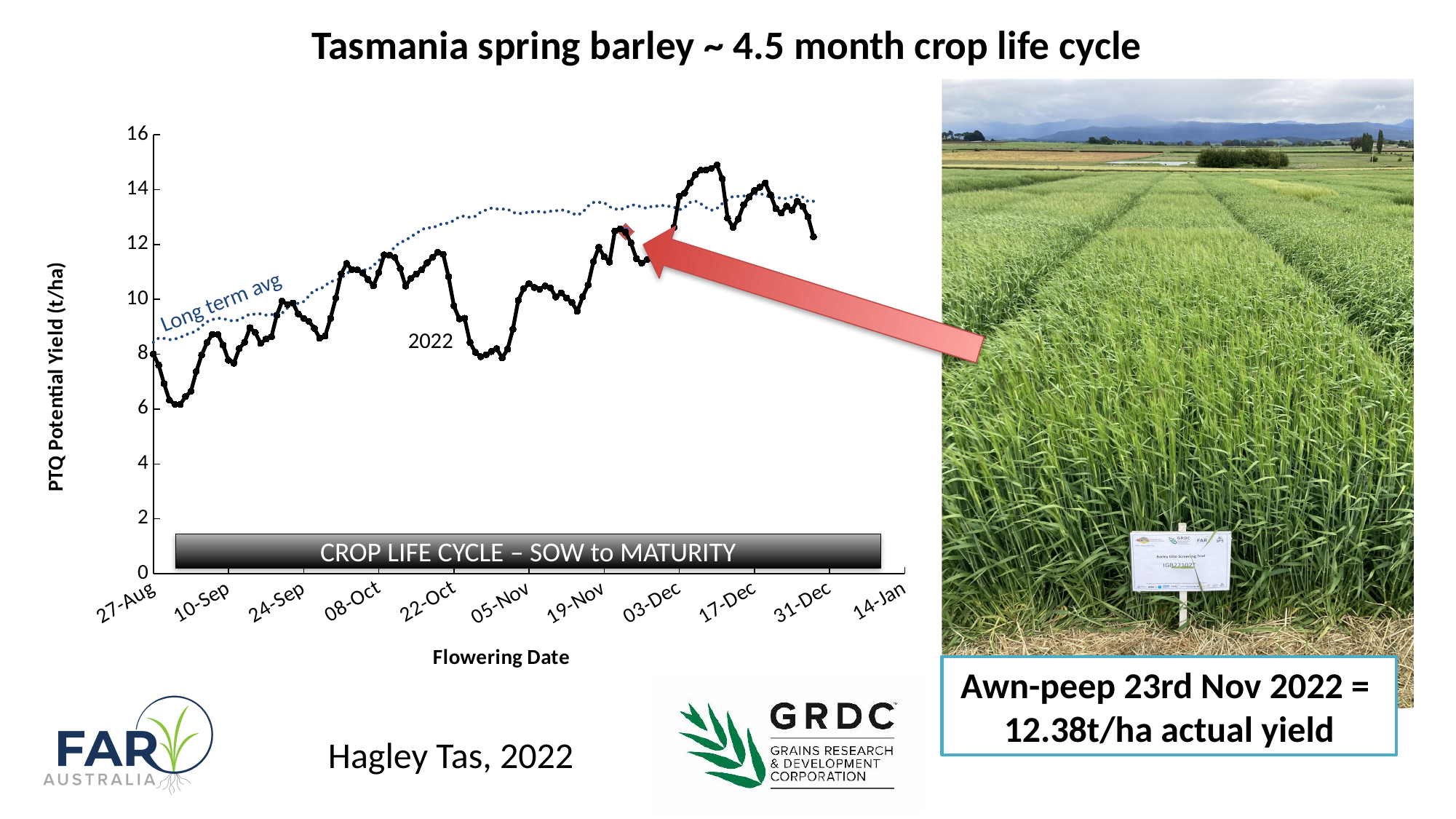
How many data series are plotted on the chart? 2 What is the title of the chart on the slide? Tasmania spring barley ~ 4.5 month crop life cycle Is the highest value reached by the 2022 line greater or less than 14? greater How many date labels are shown on the x axis of the chart? 11 Does the Long term avg line generally rise or fall from 27-Aug to 03-Dec? rise Is the value of the Long term avg line at 27-Aug greater or less than 10? less Is the lowest value reached by the 2022 line greater or less than 8? less According to the annotation on the slide, what was the actual yield for awn-peep on 23rd Nov 2022? 12.38t/ha Around 10-Dec, which line is higher: 2022 or Long term avg? 2022 Around 05-Nov, which line is higher: 2022 or Long term avg? Long term avg What kind of chart is shown on the slide? line chart